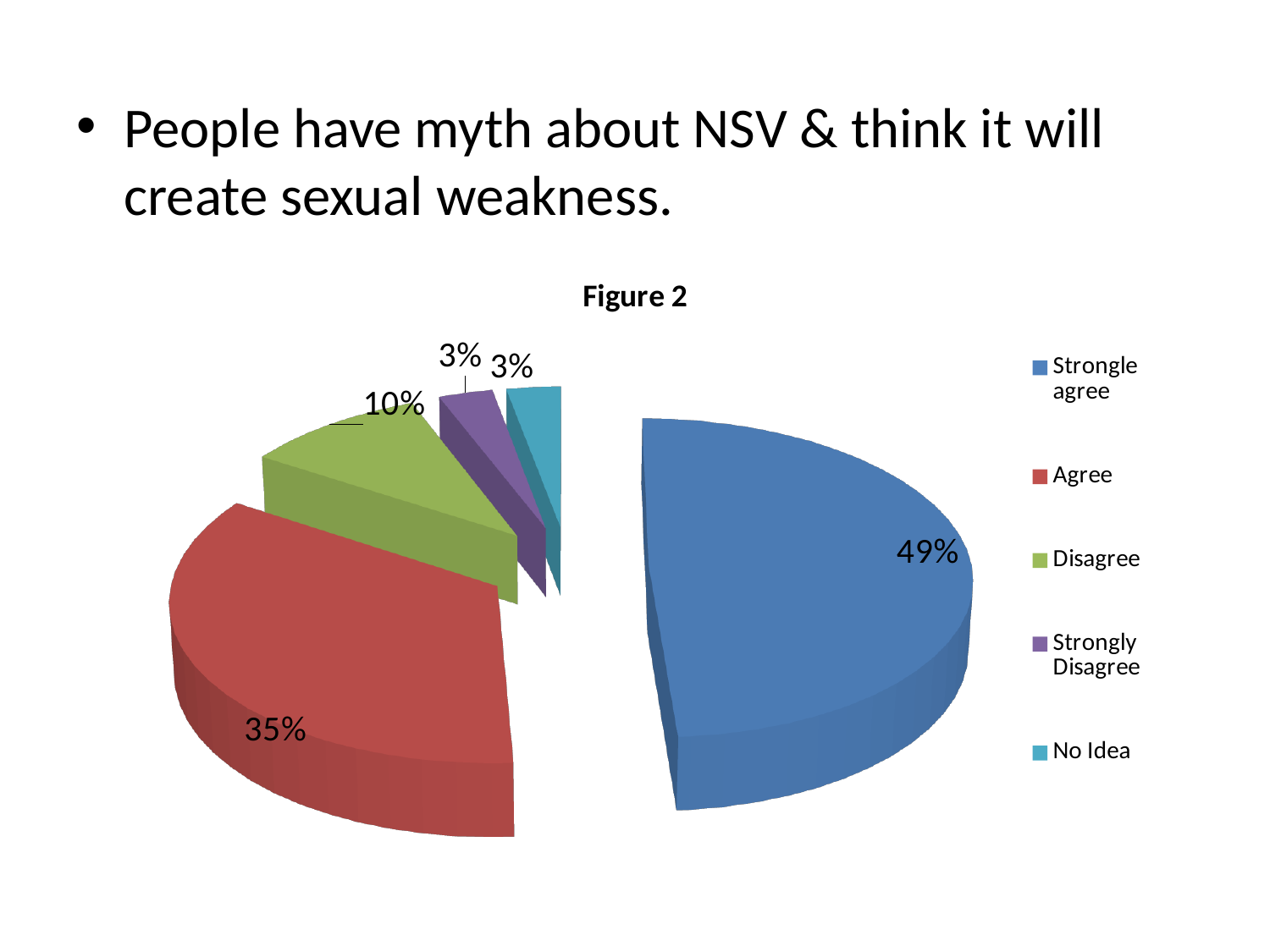
What percentage is shown for the Disagree slice? 10% Which category has the largest share of the pie? Strongle agree Which slice is larger, Agree or Disagree? Agree What percentage is shown for the Strongly Disagree slice? 3% What percentage is shown for the Agree slice? 35% What percentage is shown for the No Idea slice? 3% What colour is the Agree slice? red What kind of chart is shown on the slide? pie chart What is the difference in percentage points between the Strongle agree and Agree slices? 14 What percentage of the pie is labelled for the Strongle agree slice? 49% How many categories does the legend list? 5 What is the title of the chart? Figure 2